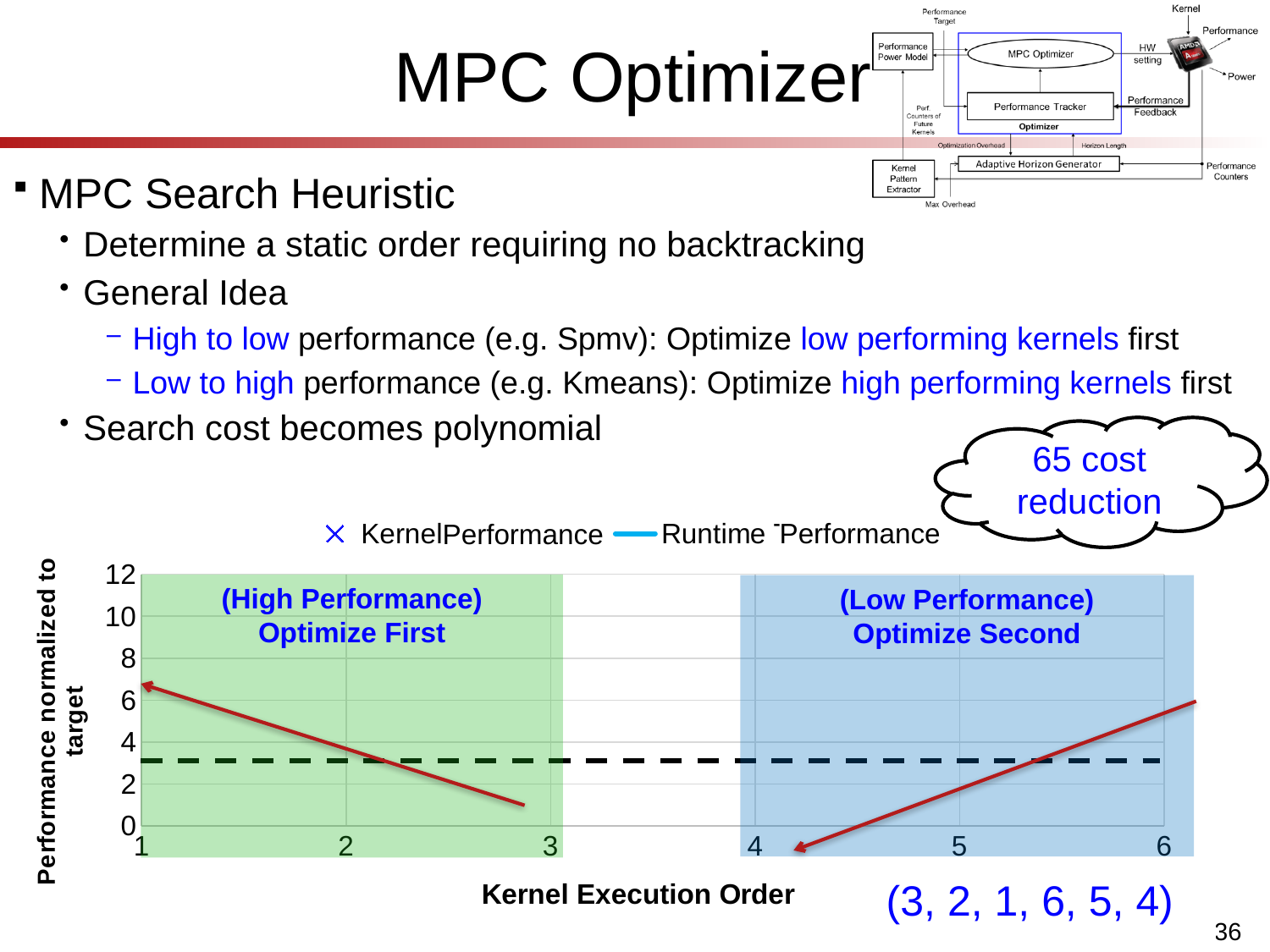
What is the title of the x axis of the chart? Kernel Execution Order What is the highest value shown on the y axis of the chart? 12 How many kernel execution order positions are shown on the x axis of the chart? 6 What is the title of the y axis of the chart? Performance normalized to target How many series does the chart legend list? 2 What is the lowest value shown on the y axis of the chart? 0